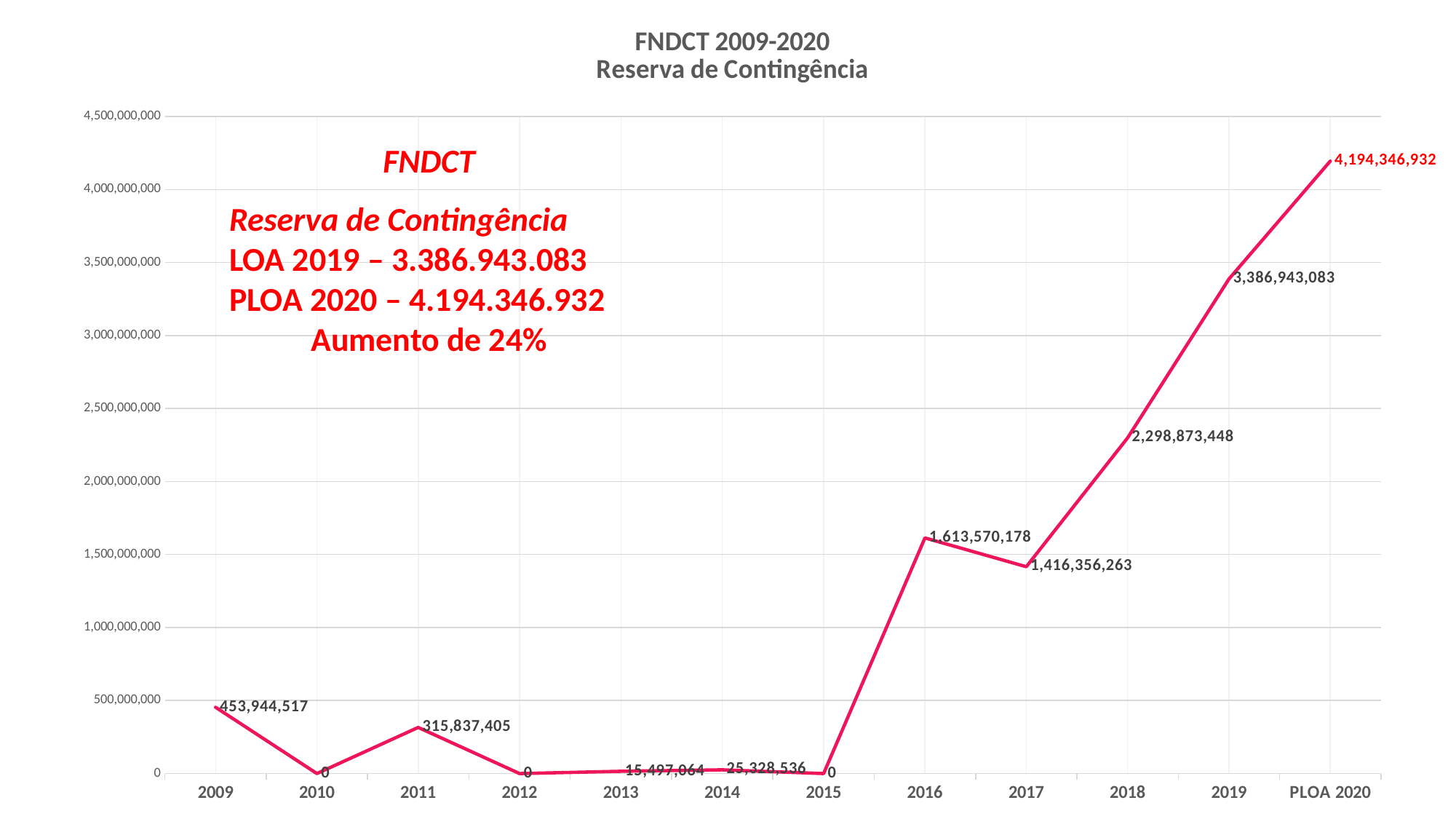
What is the difference between the values for 2016 and 2017? 197,213,915 What is the value for 2016? 1,613,570,178 What is the value for 2011? 315,837,405 Which is larger, the value for 2018 or the value for 2017? 2018 What is the title of the chart? FNDCT 2009-2020 Reserva de Contingência Which category has the highest value? PLOA 2020 What is the difference between the values for PLOA 2020 and 2019? 807,403,849 How many data points are plotted on the x axis? 12 What is the value for PLOA 2020? 4,194,346,932 Is the value for 2019 greater or less than 3,000,000,000? greater What type of chart is shown on the slide? line chart What is the value for 2009? 453,944,517